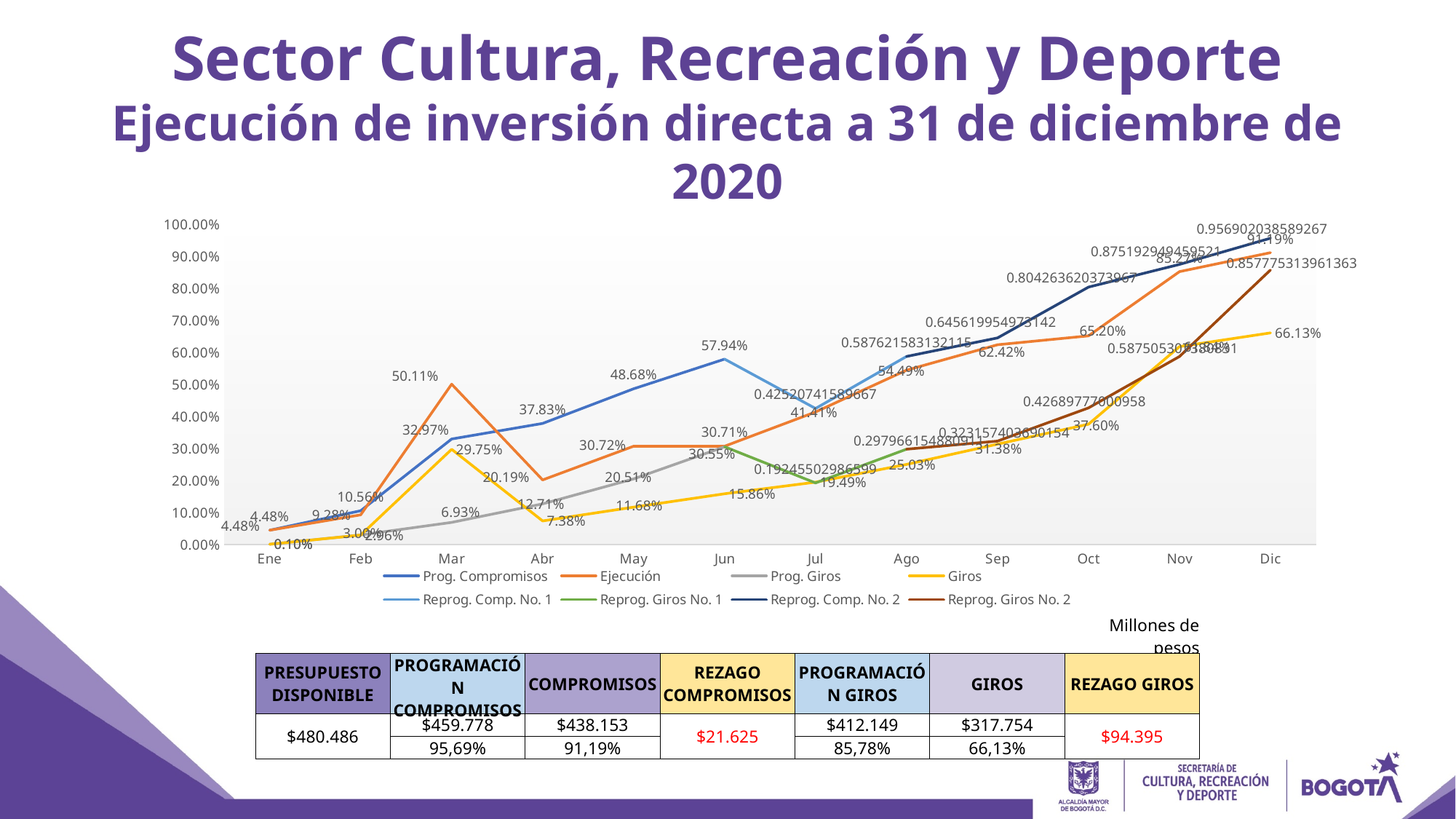
How many series does the chart legend list? 8 In Dic, which is larger: Ejecución or Giros? Ejecución What kind of chart is shown on the slide? line chart What is the value of Ejecución in Mar? 50.11% Is the value for Reprog. Comp. No. 2 in Dic greater or less than 90%? greater What is the value of Ejecución in Dic? 91.19% Does the Giros series generally rise or fall from Ene to Dic? rise What is the value of Ejecución in Oct? 65.20% What is the value of Prog. Compromisos in Jun? 57.94% What is the difference between Ejecución and Giros in Dic? 25.06% How many months are shown along the x axis of the chart? 12 What is the value of Giros in Dic? 66.13%